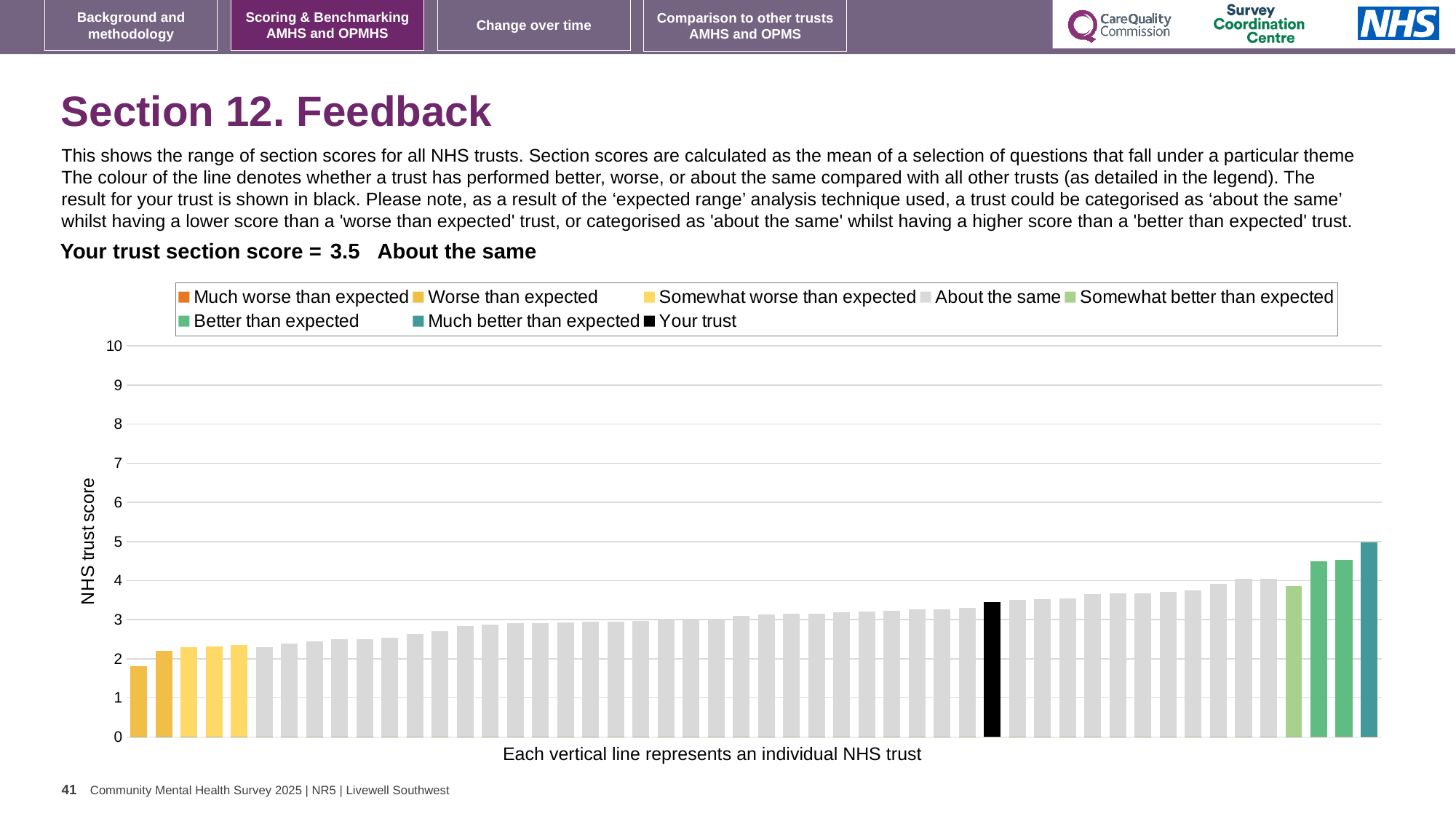
How many entries does the chart legend list? 8 Is the value of the shortest bar greater or less than 2? less Which category is your trust placed in for this section? About the same What kind of chart is shown on the slide? bar chart Is the value of the tallest bar greater or less than 4? greater Which legend category does the tallest bar belong to? Much better than expected Is the value for your trust (the black bar) greater or less than 3? greater How many bars are coloured as 'Better than expected'? 2 Do the bar values rise or fall from left to right along the x axis? rise What colour is used for the 'Your trust' bar? black What is the section score for your trust shown on the slide? 3.5 What is the title of the vertical axis? NHS trust score